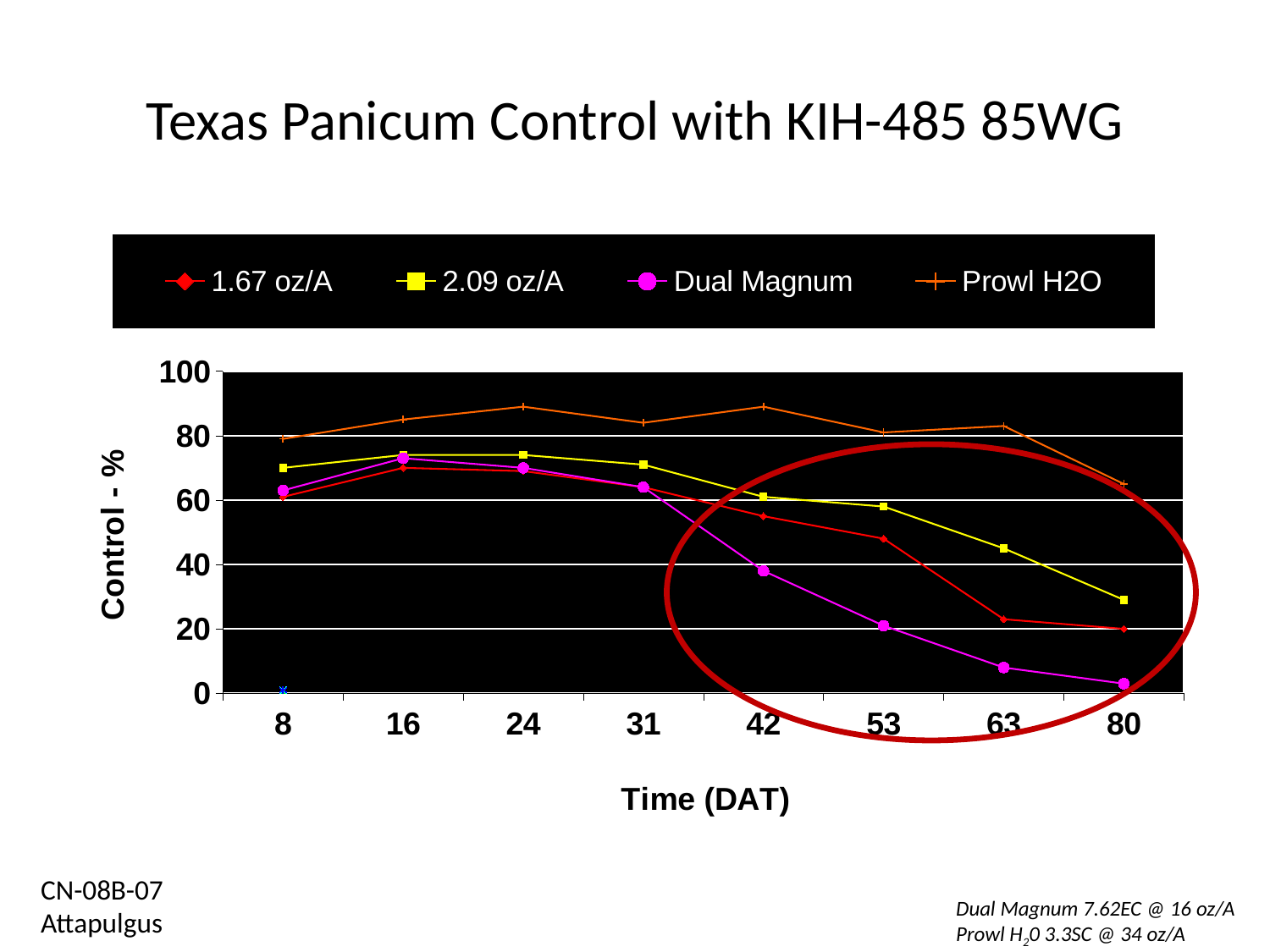
Which series has the highest control at 53 DAT? Prowl H2O Which series has the lowest control at 63 DAT? Dual Magnum How many series does the legend list? 4 How many time points are shown on the x axis? 8 What kind of chart is shown on the slide? line chart Is the value for Dual Magnum at 80 DAT greater or less than 20? less Is the value for Prowl H2O at 24 DAT greater or less than 80? greater Does the Dual Magnum line rise or fall from 31 DAT to 80 DAT? fall What is the title of the x axis? Time (DAT) Is the value for 2.09 oz/A at 80 DAT greater or less than 40? less At 80 DAT, which has the higher control: 2.09 oz/A or 1.67 oz/A? 2.09 oz/A